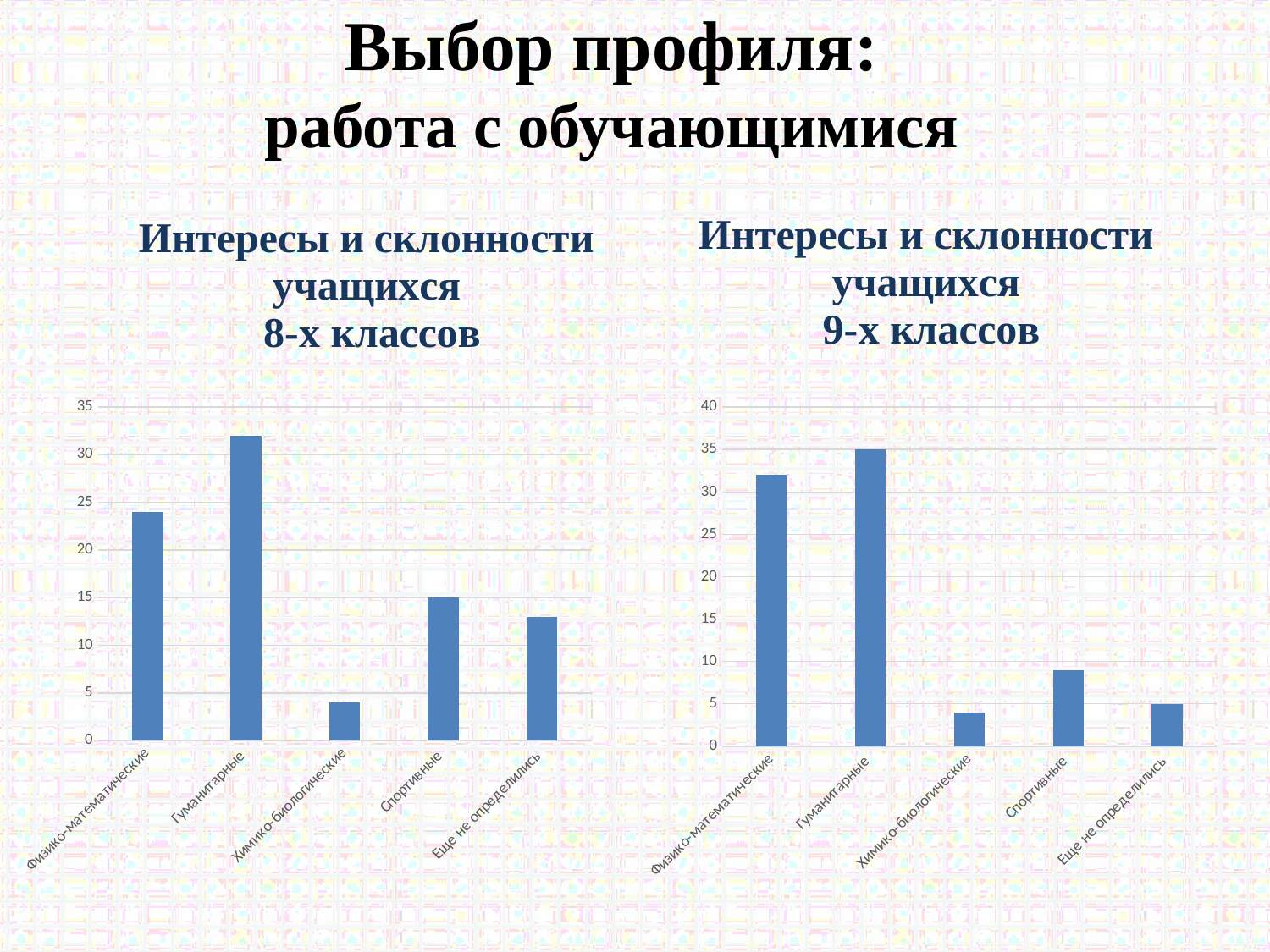
On the left chart (8-х классов), which category has the highest value? Гуманитарные On the right chart (9-х классов), is the value for Спортивные greater or less than 10? less On the right chart (9-х классов), which category has the highest value? Гуманитарные On the right chart (9-х классов), which is larger: Физико-математические or Спортивные? Физико-математические On the left chart (8-х классов), what is the value for Спортивные? 15 On the left chart (8-х классов), which is larger: Спортивные or Еще не определились? Спортивные On the right chart (9-х классов), what is the value for Гуманитарные? 35 On the right chart (9-х классов), which category has the lowest value? Химико-биологические On the left chart (8-х классов), which category has the lowest value? Химико-биологические What kind of chart is the left chart, 'Интересы и склонности учащихся 8-х классов'? bar chart On the left chart (8-х классов), is the value for Физико-математические greater or less than 20? greater How many categories are shown on the right chart, 'Интересы и склонности учащихся 9-х классов'? 5